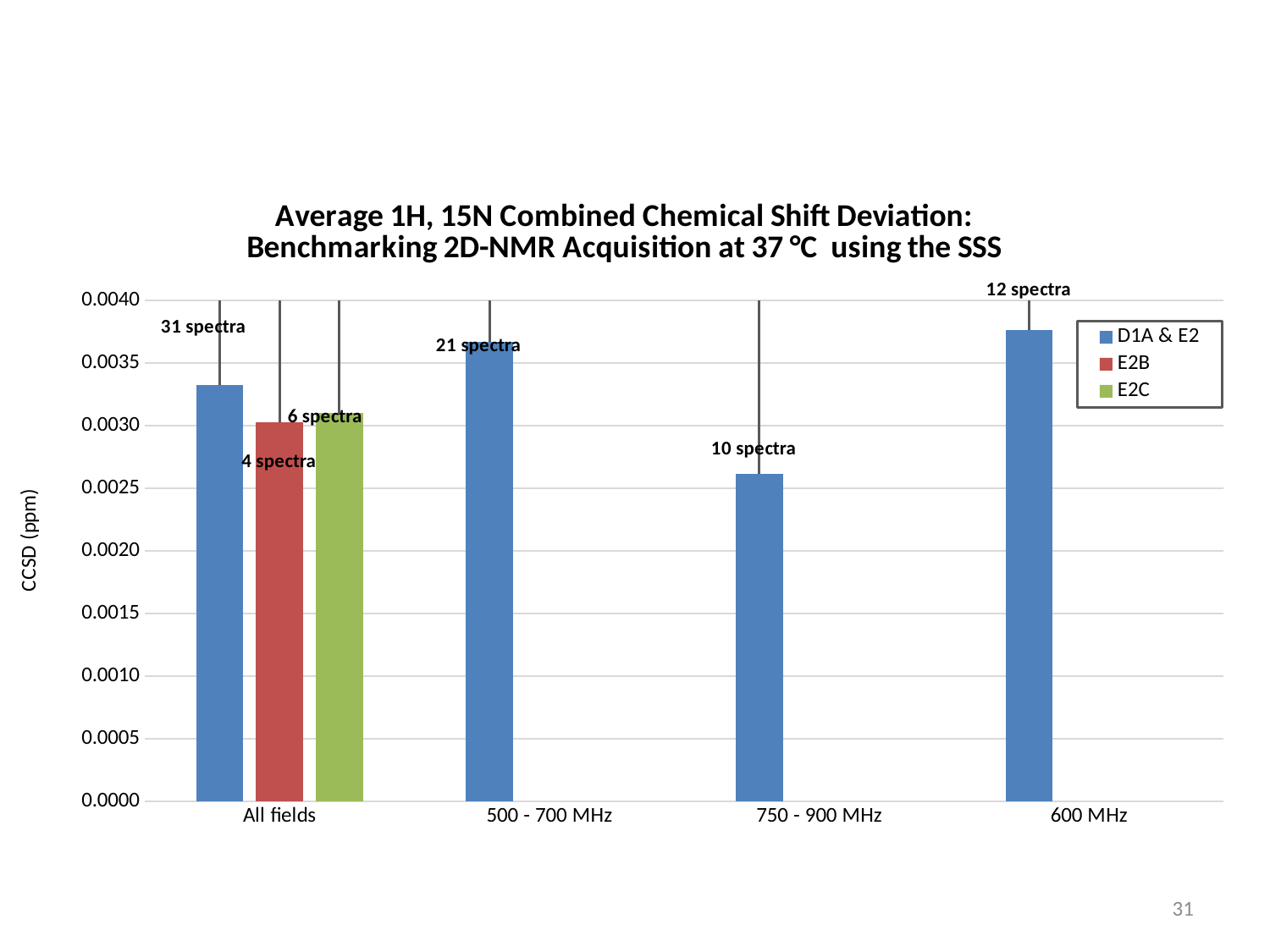
How many spectra are indicated above the 750 - 900 MHz bar? 10 spectra What is the label on the y axis? CCSD (ppm) Which is larger, the D1A & E2 value for All fields or for 750 - 900 MHz? All fields Is the D1A & E2 value for All fields greater or less than 0.0030? greater What kind of chart is shown on the slide? bar chart Which category has the highest D1A & E2 bar? 600 MHz How many categories are shown on the x axis? 4 Which is larger, the D1A & E2 value for 600 MHz or for 750 - 900 MHz? 600 MHz Is the D1A & E2 value for 600 MHz greater or less than 0.0035? greater Is the D1A & E2 value for 750 - 900 MHz greater or less than 0.0030? less Which category has the lowest D1A & E2 bar? 750 - 900 MHz How many series does the legend list? 3